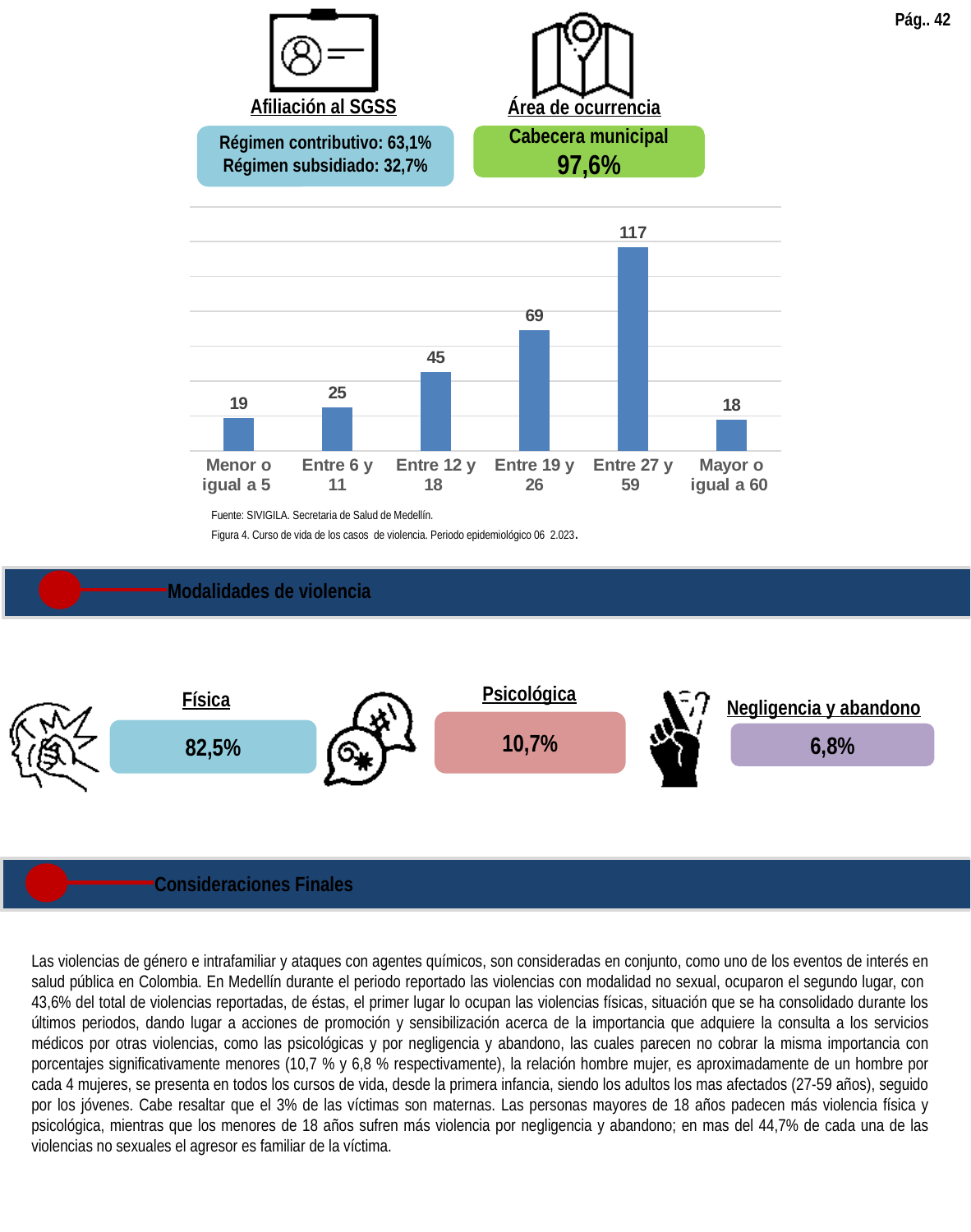
What is the value for the 'Entre 12 y 18' category in the bar chart? 45 What is the value for the 'Menor o igual a 5' category in the bar chart? 19 Which is larger in the bar chart: the value for 'Entre 6 y 11' or the value for 'Menor o igual a 5'? Entre 6 y 11 What is the value for the 'Mayor o igual a 60' category in the bar chart? 18 What is the difference between the values for 'Entre 12 y 18' and 'Entre 6 y 11' in the bar chart? 20 What is the difference between the values for 'Entre 27 y 59' and 'Entre 19 y 26' in the bar chart? 48 What kind of chart is shown on the slide? Bar chart What is the value for the 'Entre 27 y 59' category in the bar chart? 117 Which category has the lowest value in the bar chart? Mayor o igual a 60 Which category has the highest value in the bar chart? Entre 27 y 59 According to the caption, what is the figure number of the chart on the slide? Figura 4 How many categories are shown on the x axis of the bar chart? 6